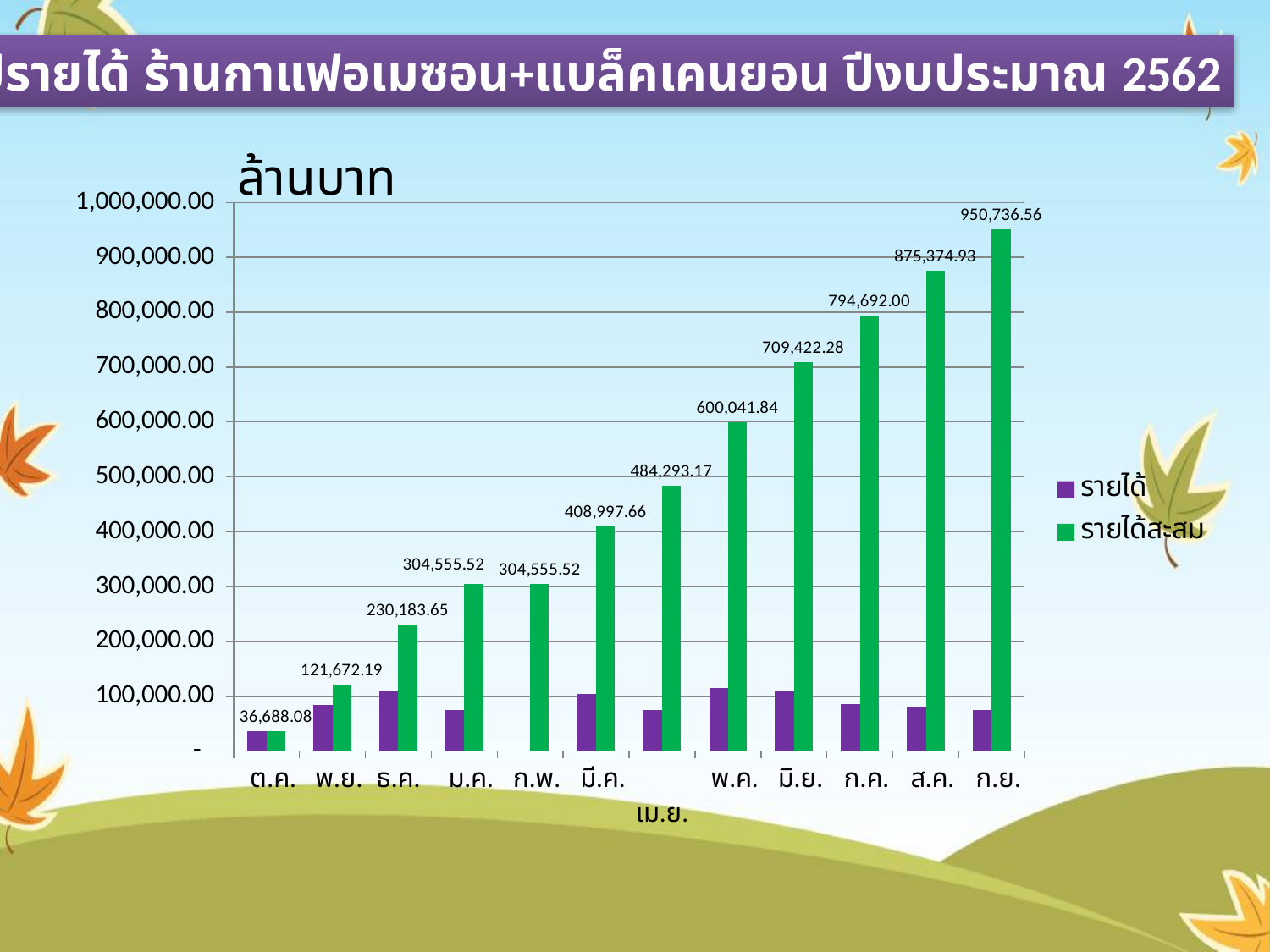
What is the difference between the รายได้สะสม values for ก.ย. and ส.ค.? 75,361.63 What is the value of รายได้สะสม for พ.ค.? 600,041.84 Is the รายได้ value for ม.ค. greater or less than 100,000.00? less What is the value of รายได้สะสม for ก.ย.? 950,736.56 Which month has the highest รายได้สะสม value? ก.ย. How many series does the legend list? 2 Which colour represents the รายได้สะสม series? green Does the รายได้สะสม series rise or fall from ต.ค. to ก.ย.? rise How many months (categories) are shown on the x axis? 12 What is the value of รายได้สะสม for ต.ค.? 36,688.08 What type of chart is shown on the slide? bar chart Which month has the lowest รายได้สะสม value? ต.ค.